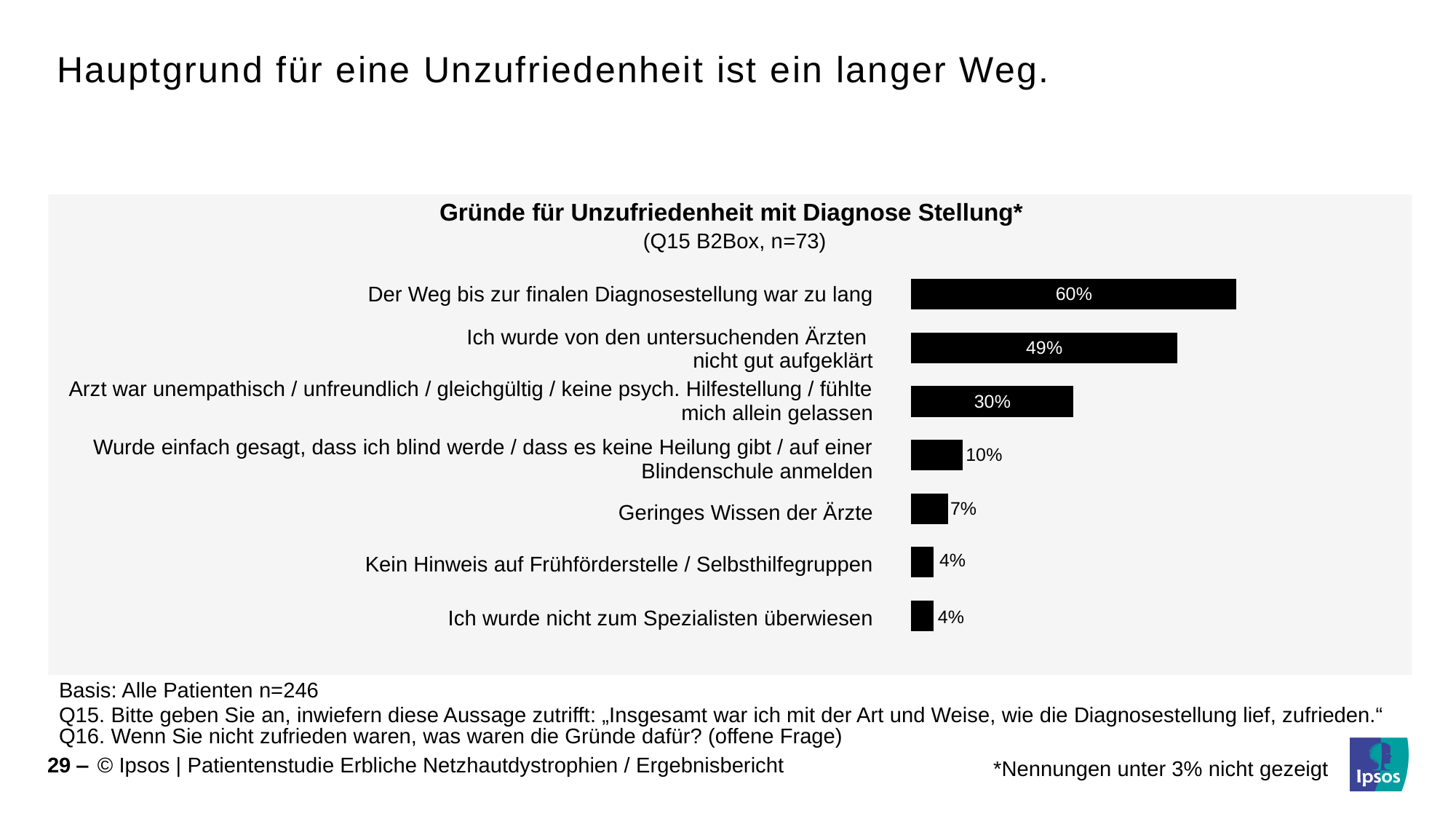
What value is shown for "Ich wurde von den untersuchenden Ärzten nicht gut aufgeklärt"? 49% What percentage is shown for "Der Weg bis zur finalen Diagnosestellung war zu lang"? 60% What is the sample size (n) given in the chart subtitle? n=73 What is the title of the chart? Gründe für Unzufriedenheit mit Diagnose Stellung* Which is larger: the value for "Arzt war unempathisch / unfreundlich / gleichgültig / keine psych. Hilfestellung / fühlte mich allein gelassen" or the value for "Wurde einfach gesagt, dass ich blind werde / dass es keine Heilung gibt / auf einer Blindenschule anmelden"? Arzt war unempathisch / unfreundlich / gleichgültig / keine psych. Hilfestellung / fühlte mich allein gelassen Which reason has the highest percentage? Der Weg bis zur finalen Diagnosestellung war zu lang What is the difference between the values for "Arzt war unempathisch / unfreundlich / gleichgültig / keine psych. Hilfestellung / fühlte mich allein gelassen" and "Geringes Wissen der Ärzte"? 23% What percentage is shown for "Geringes Wissen der Ärzte"? 7% What is the difference between the values for "Der Weg bis zur finalen Diagnosestellung war zu lang" and "Ich wurde von den untersuchenden Ärzten nicht gut aufgeklärt"? 11% What kind of chart is shown on the slide? Bar chart What value is shown for "Ich wurde nicht zum Spezialisten überwiesen"? 4% How many reasons (categories) are shown in the chart? 7